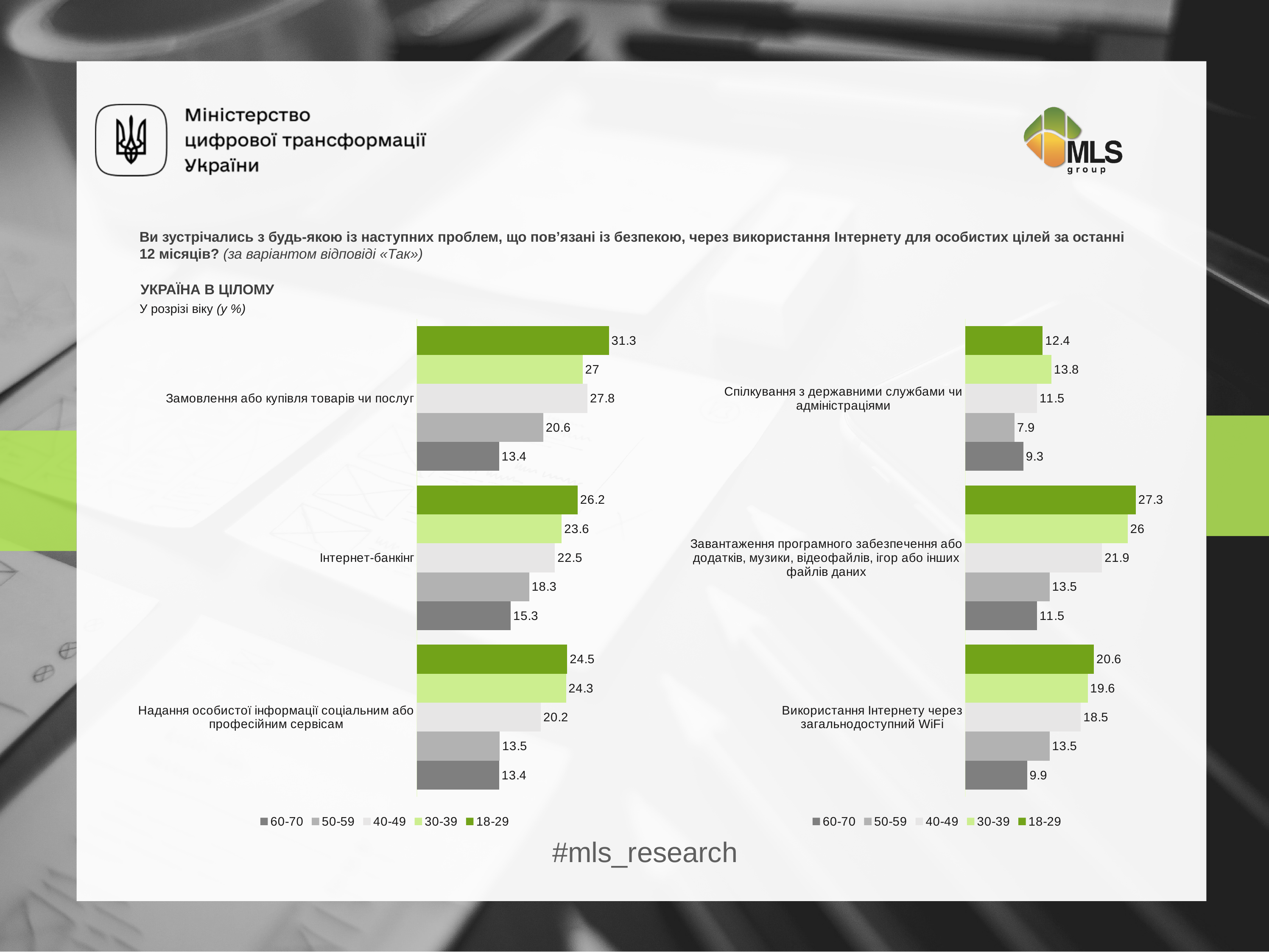
In the right chart, which age group has the highest value for "Спілкування з державними службами чи адміністраціями"? 30-39 In the left chart, what is the value for the 60-70 age group for "Інтернет-банкінг"? 15.3 In the right chart, which age group has the lowest value for "Використання Інтернету через загальнодоступний WiFi"? 60-70 In the left chart, which is larger for "Інтернет-банкінг": the 30-39 value or the 40-49 value? 30-39 How many series does the legend of the left chart list? 5 In the right chart, what is the value for the 50-59 age group for "Спілкування з державними службами чи адміністраціями"? 7.9 In the right chart, which age group has the highest value for "Завантаження програмного забезпечення або додатків, музики, відеофайлів, ігор або інших файлів даних"? 18-29 In the left chart, what is the value for the 18-29 age group for "Замовлення або купівля товарів чи послуг"? 31.3 How many categories are shown in the right chart? 3 In the left chart, what is the difference between the 18-29 and 60-70 values for "Замовлення або купівля товарів чи послуг"? 17.9 What kind of chart is the left chart? Bar chart In the right chart, what is the difference between the 30-39 and 40-49 values for "Завантаження програмного забезпечення або додатків, музики, відеофайлів, ігор або інших файлів даних"? 4.1